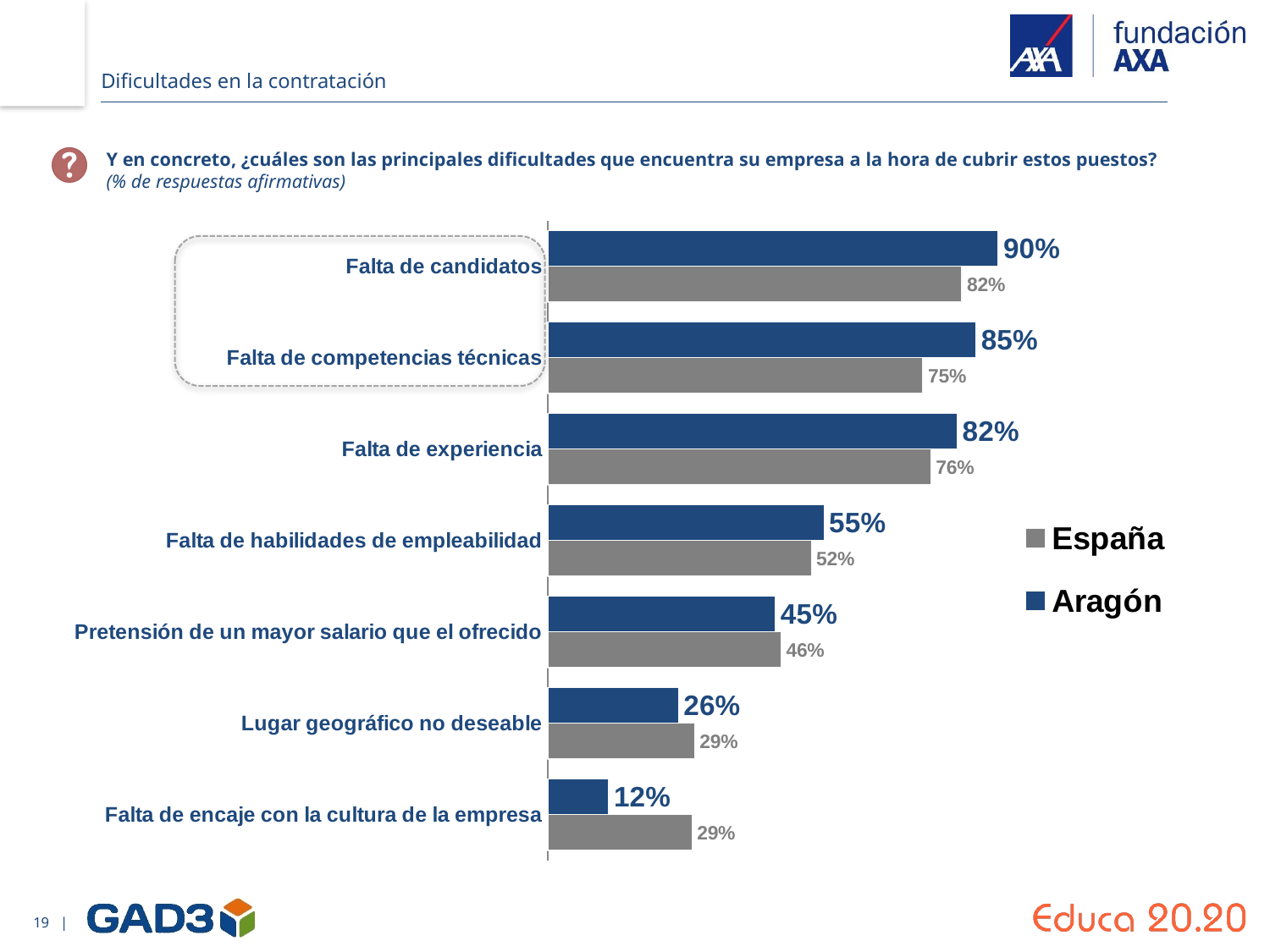
How many series does the legend list? 2 For 'Falta de encaje con la cultura de la empresa', which is larger, the Aragón value or the España value? España Which colour represents Aragón in the chart? Blue What is the difference between the Aragón and España values for 'Falta de competencias técnicas'? 10 percentage points Which category has the lowest value for Aragón? Falta de encaje con la cultura de la empresa What is the value for Aragón for 'Falta de encaje con la cultura de la empresa'? 12% For 'Falta de experiencia', which is larger, the Aragón value or the España value? Aragón What is the value for España for 'Falta de competencias técnicas'? 75% What is the value for Aragón for 'Falta de candidatos'? 90% Which category has the highest value for Aragón? Falta de candidatos What kind of chart is shown on the slide? Bar chart How many categories are shown in the chart? 7